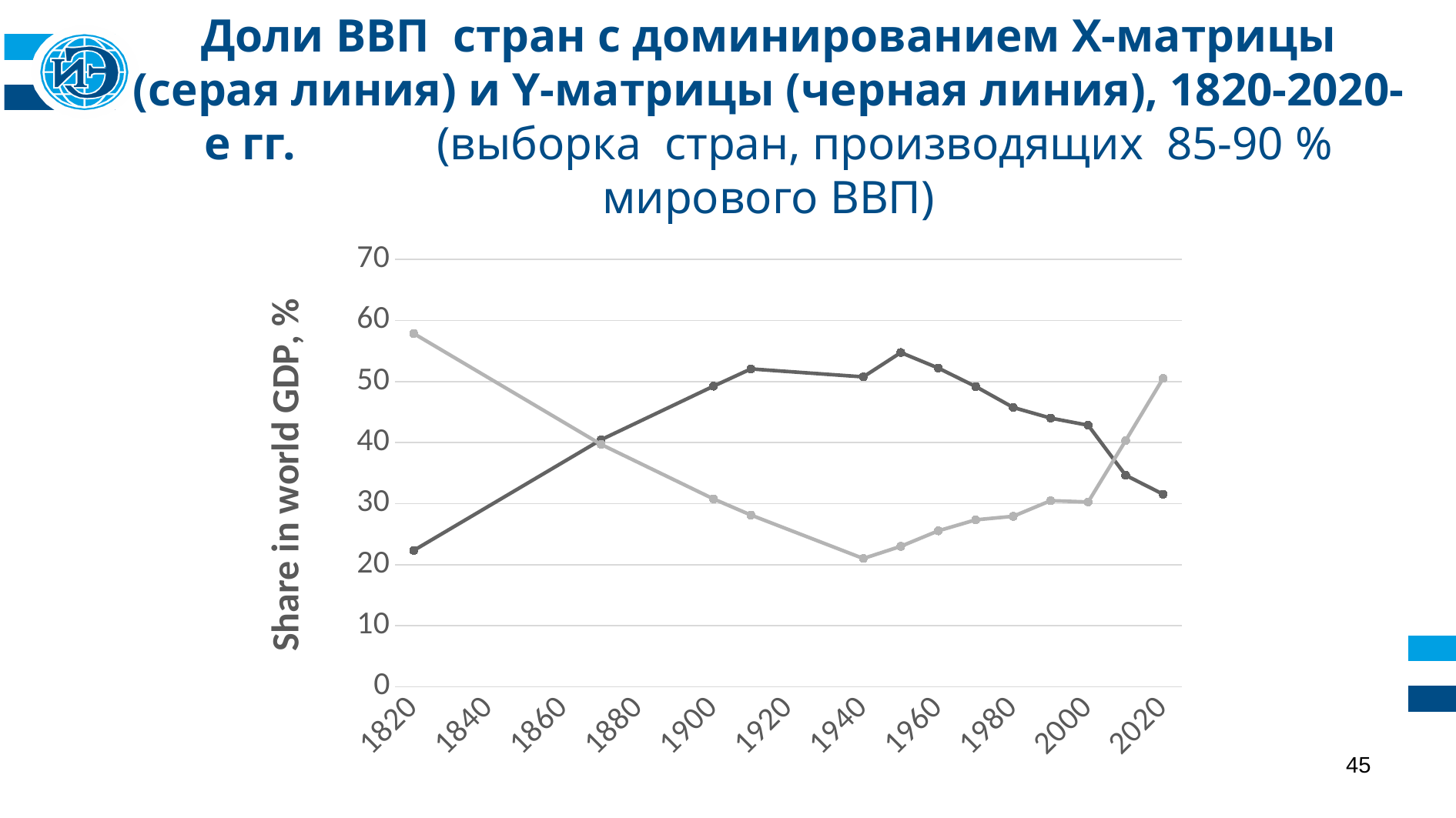
Does the grey line (X-matrix) rise or fall between 1940 and 2020? rise Does the grey line (X-matrix) rise or fall between 1820 and 1940? fall Is the value of the grey line (X-matrix) in 1820 greater or less than 50? greater Is the value of the black line (Y-matrix) in 2020 greater or less than 40? less Is the value of the black line (Y-matrix) in 1820 greater or less than 30? less Which line has the higher value in 1820, the grey line (X-matrix) or the black line (Y-matrix)? grey line (X-matrix) What is the title of the vertical axis? Share in world GDP, % What kind of chart is shown on the slide? line chart Does the black line (Y-matrix) rise or fall between 1950 and 2020? fall How many year labels are shown along the x axis? 11 Which line has the higher value in 2020, the grey line (X-matrix) or the black line (Y-matrix)? grey line (X-matrix)